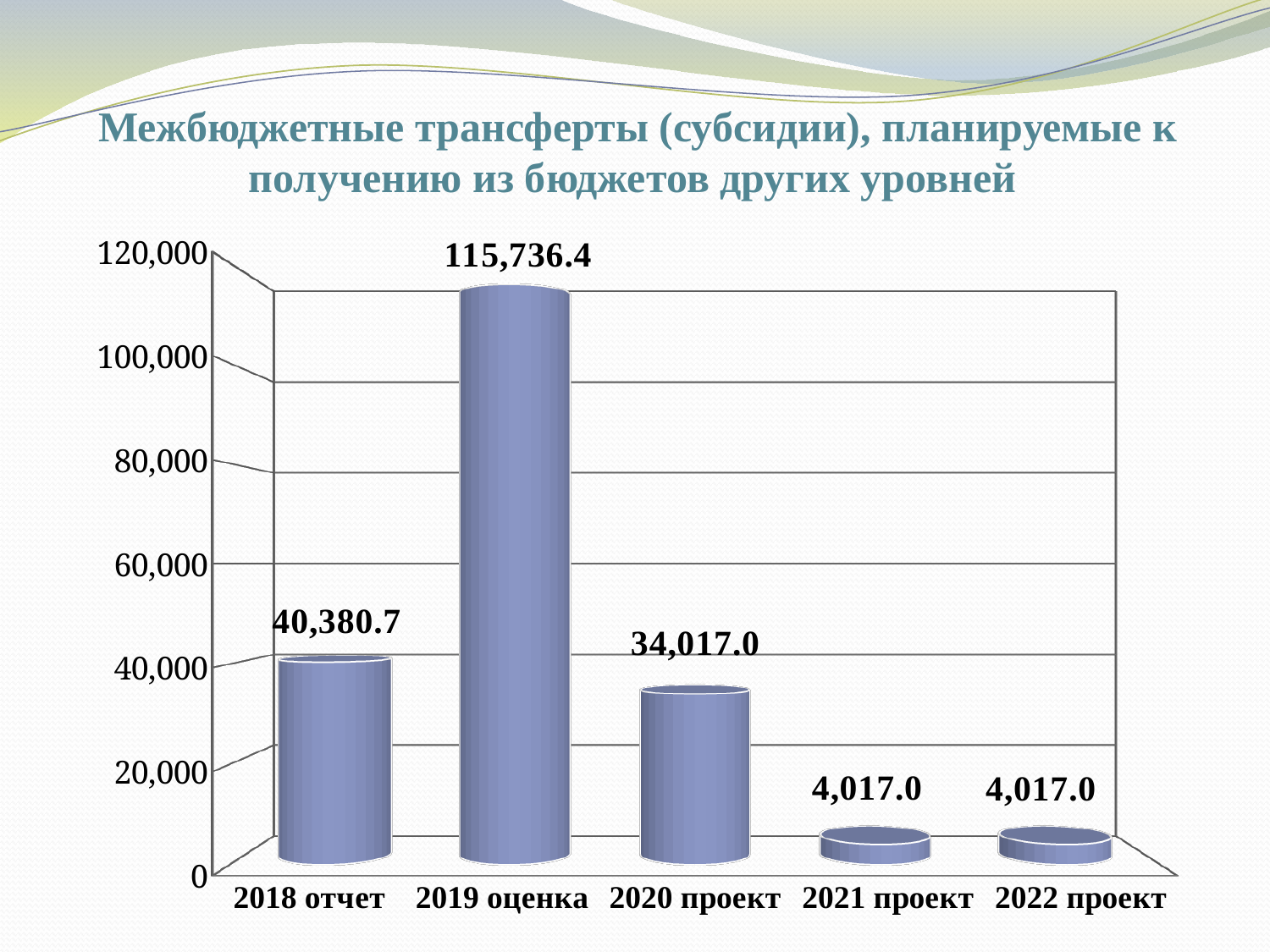
Which is larger, the value for 2018 отчет or the value for 2020 проект? 2018 отчет What is the difference between the values for 2019 оценка and 2018 отчет? 75,355.7 Do the values rise or fall from 2019 оценка to 2021 проект? fall What is the value for 2020 проект? 34,017.0 How many categories are shown on the x axis? 5 Which category has the highest value? 2019 оценка What is the value for 2019 оценка? 115,736.4 What kind of chart is shown on the slide? bar chart What is the difference between the values for 2020 проект and 2021 проект? 30,000.0 What is the value for 2018 отчет? 40,380.7 Is the value for 2019 оценка greater or less than 100,000? greater What is the value for 2022 проект? 4,017.0